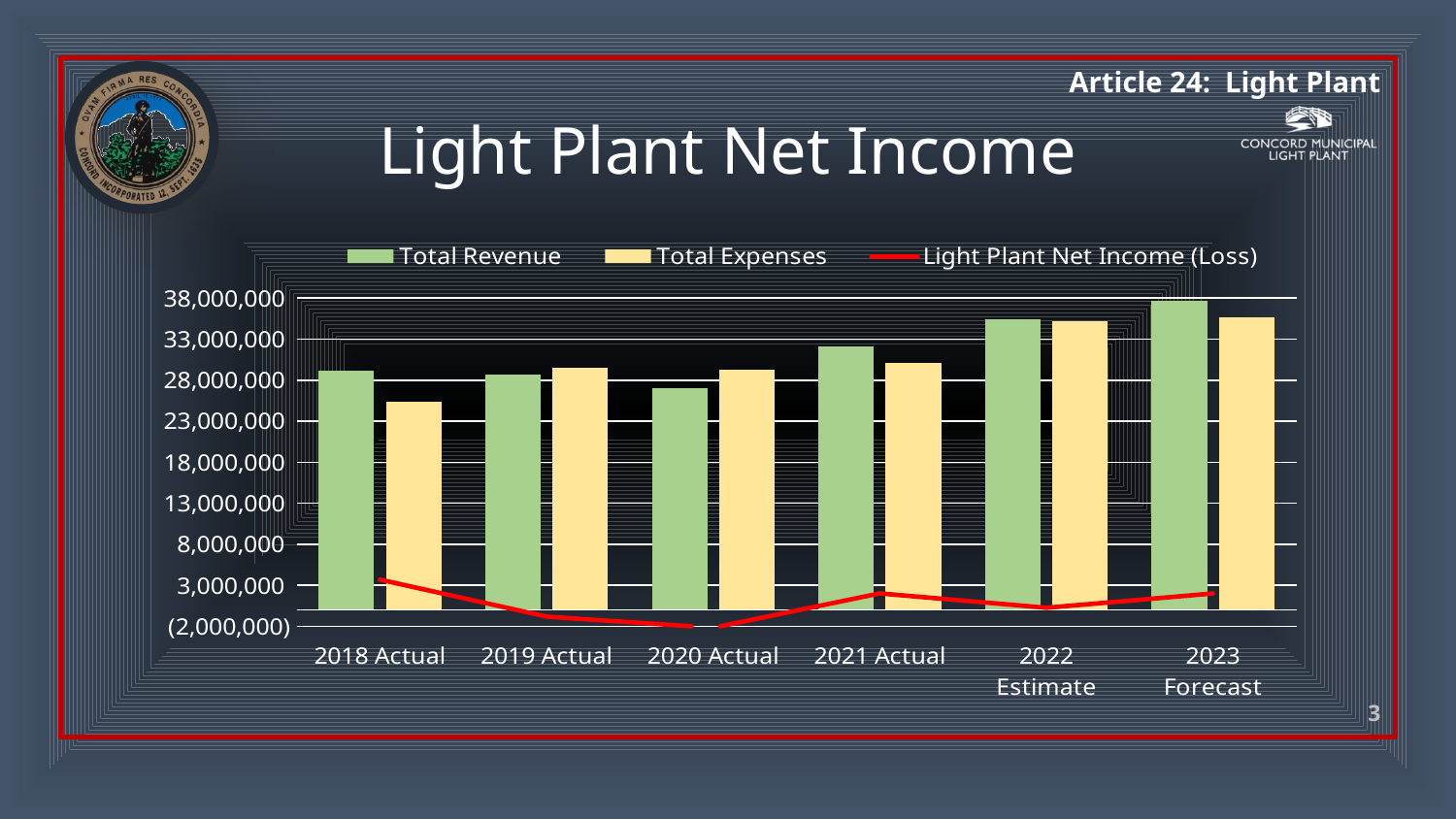
What is the title of the chart? Light Plant Net Income How many categories are shown on the x axis of the chart? 6 Is the Total Revenue value for 2020 Actual greater or less than 28,000,000? less Is the Total Expenses value for 2018 Actual greater or less than 28,000,000? less Which category has the highest Total Revenue? 2023 Forecast Which category has the lowest Total Expenses? 2018 Actual What kind of chart is shown on the slide? Bar chart with a line series Does Total Revenue rise or fall from 2021 Actual to 2023 Forecast? rise For 2020 Actual, which is larger: Total Revenue or Total Expenses? Total Expenses In which category is the Light Plant Net Income (Loss) line at its lowest? 2020 Actual How many series does the chart legend list? 3 Is the Total Revenue value for 2023 Forecast greater or less than 33,000,000? greater